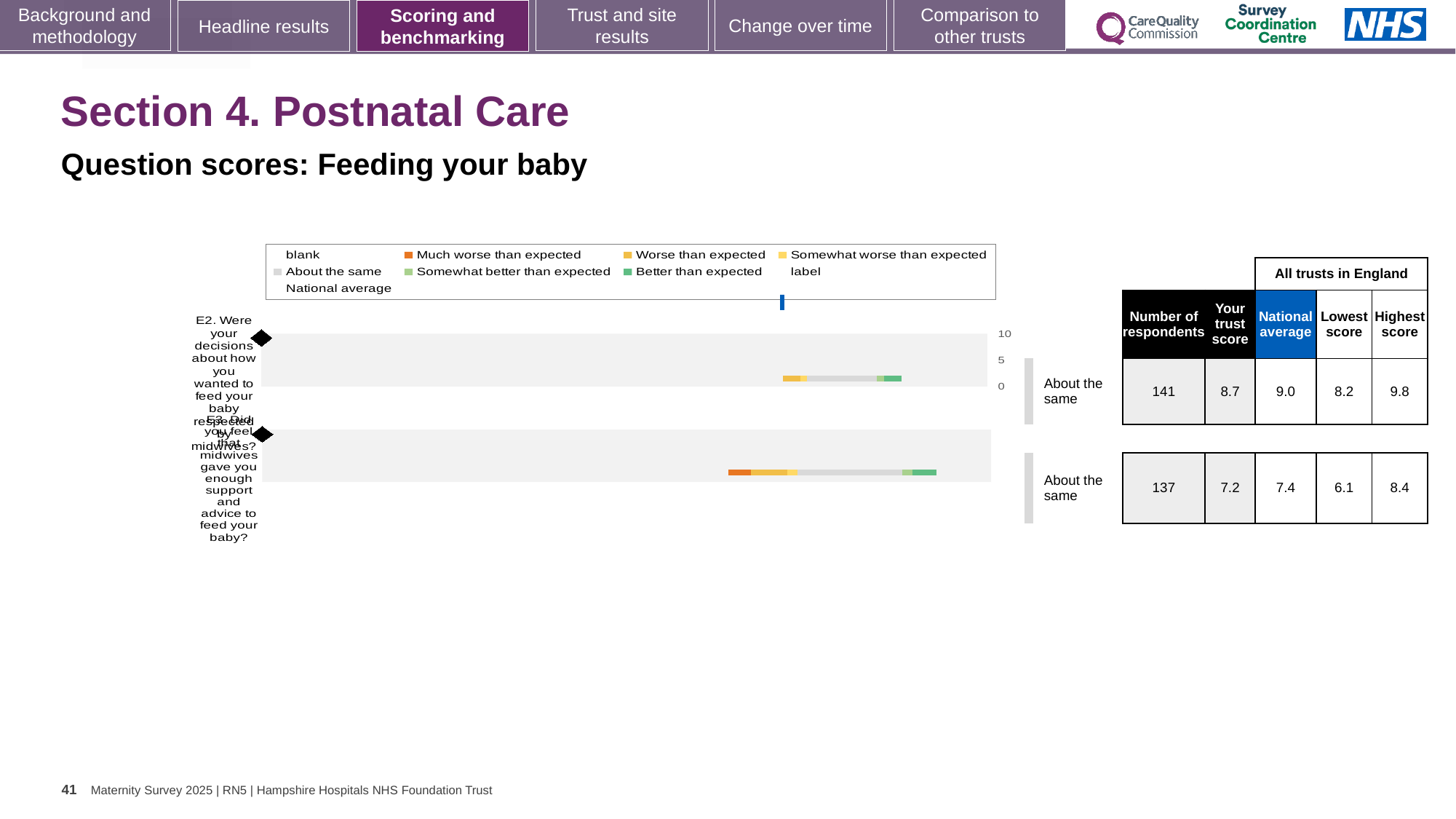
How many questions (categories) are plotted in the Feeding your baby chart? 2 Which question has the higher trust score, E2 or E3? E2 By how much does the national average exceed the trust score for question E3? 0.2 What is the lowest score among all trusts in England for question E3? 6.1 What benchmark category is shown for question E2? About the same What kind of chart is used to show the question scores for Feeding your baby? bar chart What is the trust score for question E2 (decisions about how you wanted to feed your baby respected by midwives)? 8.7 What is the subtitle of the chart on this slide? Question scores: Feeding your baby How many respondents answered question E2? 141 Which question has the larger number of respondents, E2 or E3? E2 What is the national average for question E3 (midwives gave you enough support and advice to feed your baby)? 7.4 What is the difference between the highest score and the lowest score for question E2? 1.6